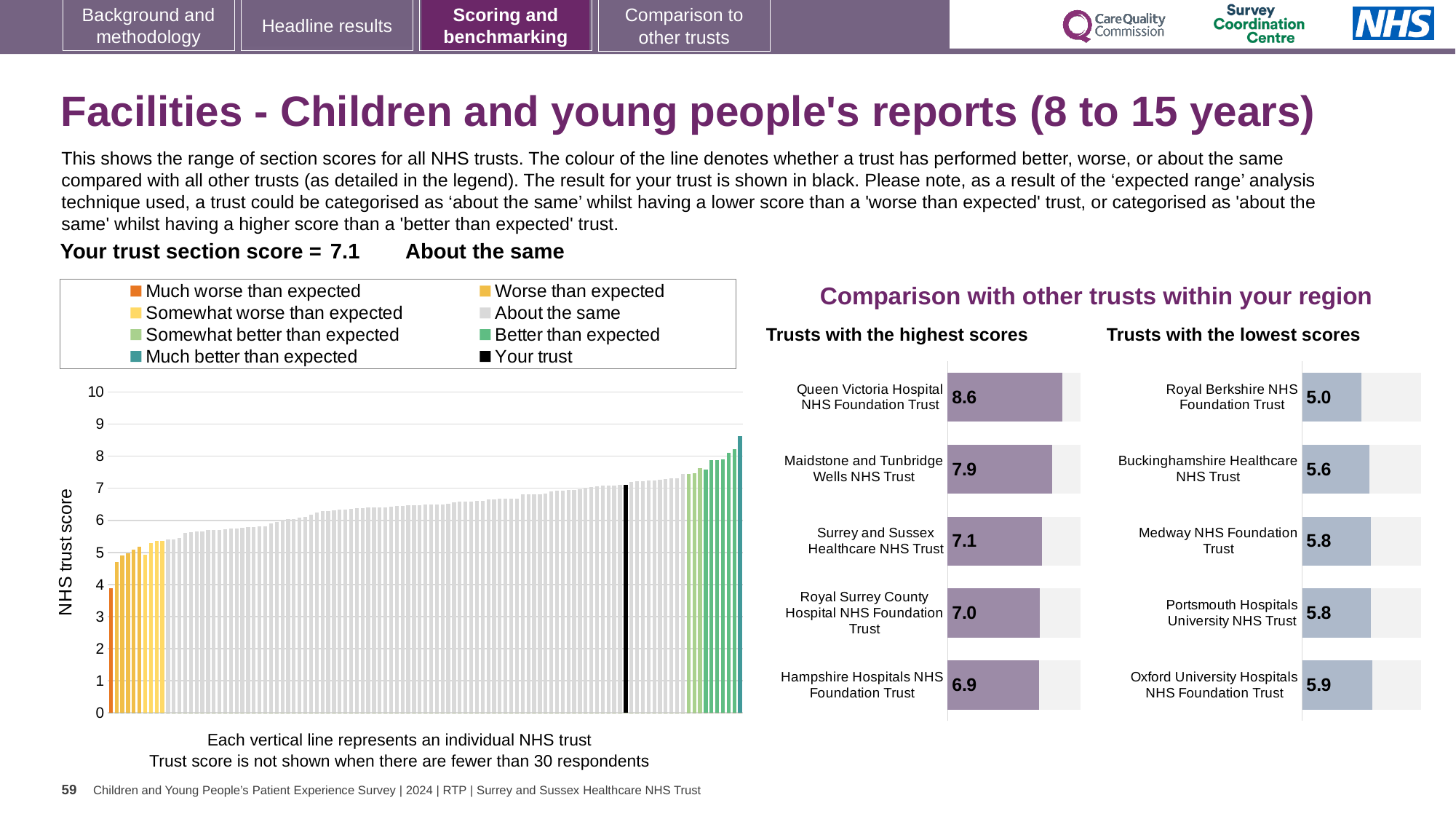
In the 'Trusts with the lowest scores' chart, which trust has the lowest score? Royal Berkshire NHS Foundation Trust In the 'Trusts with the highest scores' chart, what is the difference between the scores of Queen Victoria Hospital NHS Foundation Trust and Maidstone and Tunbridge Wells NHS Trust? 0.7 In the 'Trusts with the highest scores' chart, which trust has the highest score? Queen Victoria Hospital NHS Foundation Trust What kind of chart is the large chart on the left showing NHS trust scores? Bar chart In the 'Trusts with the highest scores' chart, what is the score for Queen Victoria Hospital NHS Foundation Trust? 8.6 How many trusts are listed in the 'Trusts with the lowest scores' chart? 5 In the large chart on the left, is the value of the lowest (orange) bar greater or less than 5? less In the 'Trusts with the lowest scores' chart, which has the larger score: Buckinghamshire Healthcare NHS Trust or Medway NHS Foundation Trust? Medway NHS Foundation Trust How many entries does the legend of the large chart on the left list? 8 In the 'Trusts with the highest scores' chart, what is the score for Hampshire Hospitals NHS Foundation Trust? 6.9 In the 'Trusts with the lowest scores' chart, what is the difference between the scores of Oxford University Hospitals NHS Foundation Trust and Royal Berkshire NHS Foundation Trust? 0.9 In the 'Trusts with the lowest scores' chart, what is the score for Royal Berkshire NHS Foundation Trust? 5.0